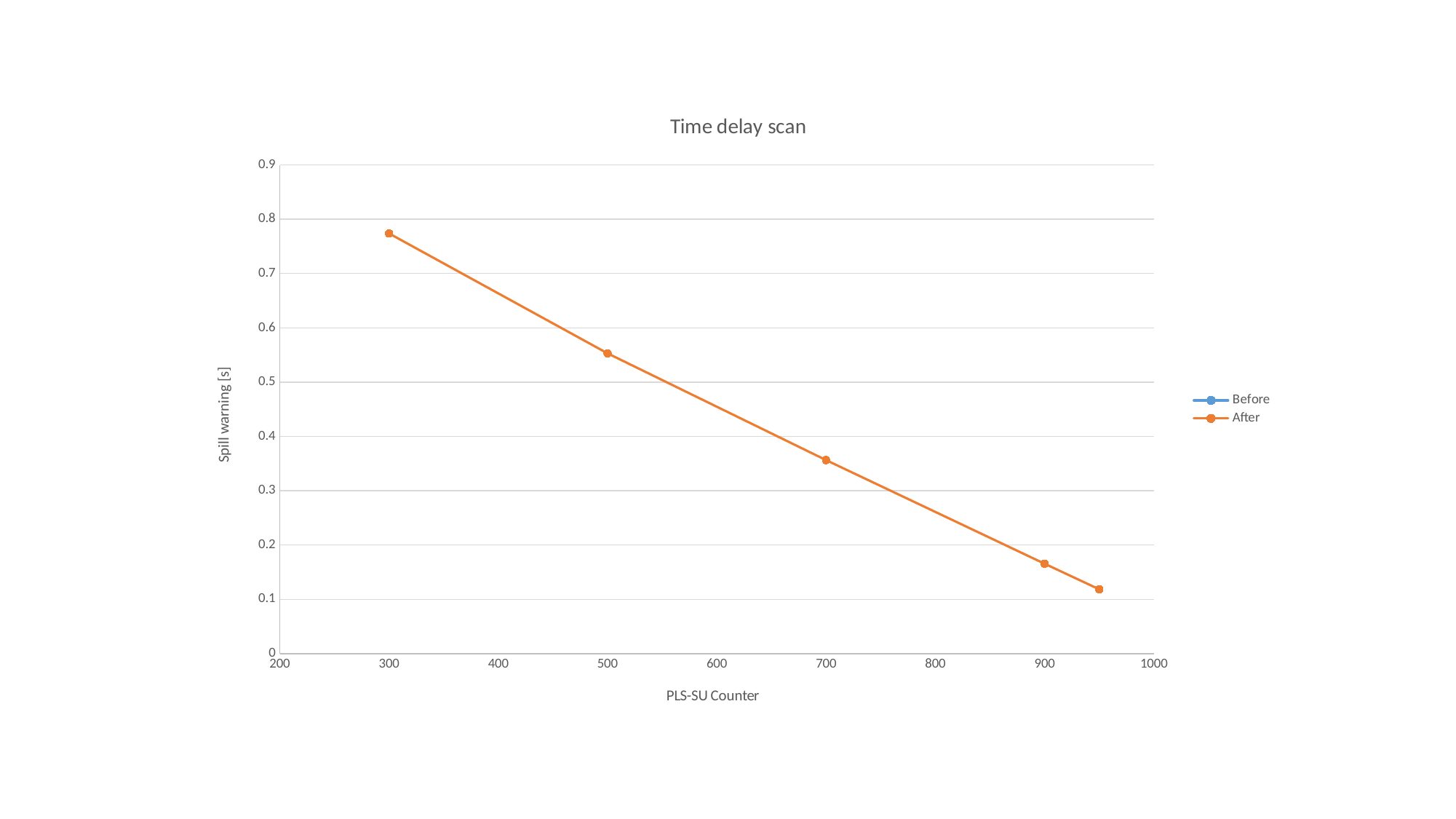
What is the label of the y axis? Spill warning [s] How many series does the legend list? 2 Is the spill warning at PLS-SU Counter 300 greater or less than 0.7? greater Is the spill warning at PLS-SU Counter 700 greater or less than 0.3? greater Which has the larger spill warning: PLS-SU Counter 500 or PLS-SU Counter 900? 500 What kind of chart is shown on the slide? line chart How many data points are plotted on the visible line? 5 Is the spill warning at PLS-SU Counter 500 greater or less than 0.6? less What is the title of the chart? Time delay scan Do the values rise or fall as the PLS-SU Counter increases? fall At which PLS-SU Counter value is the spill warning lowest? 950 At which PLS-SU Counter value is the spill warning highest? 300